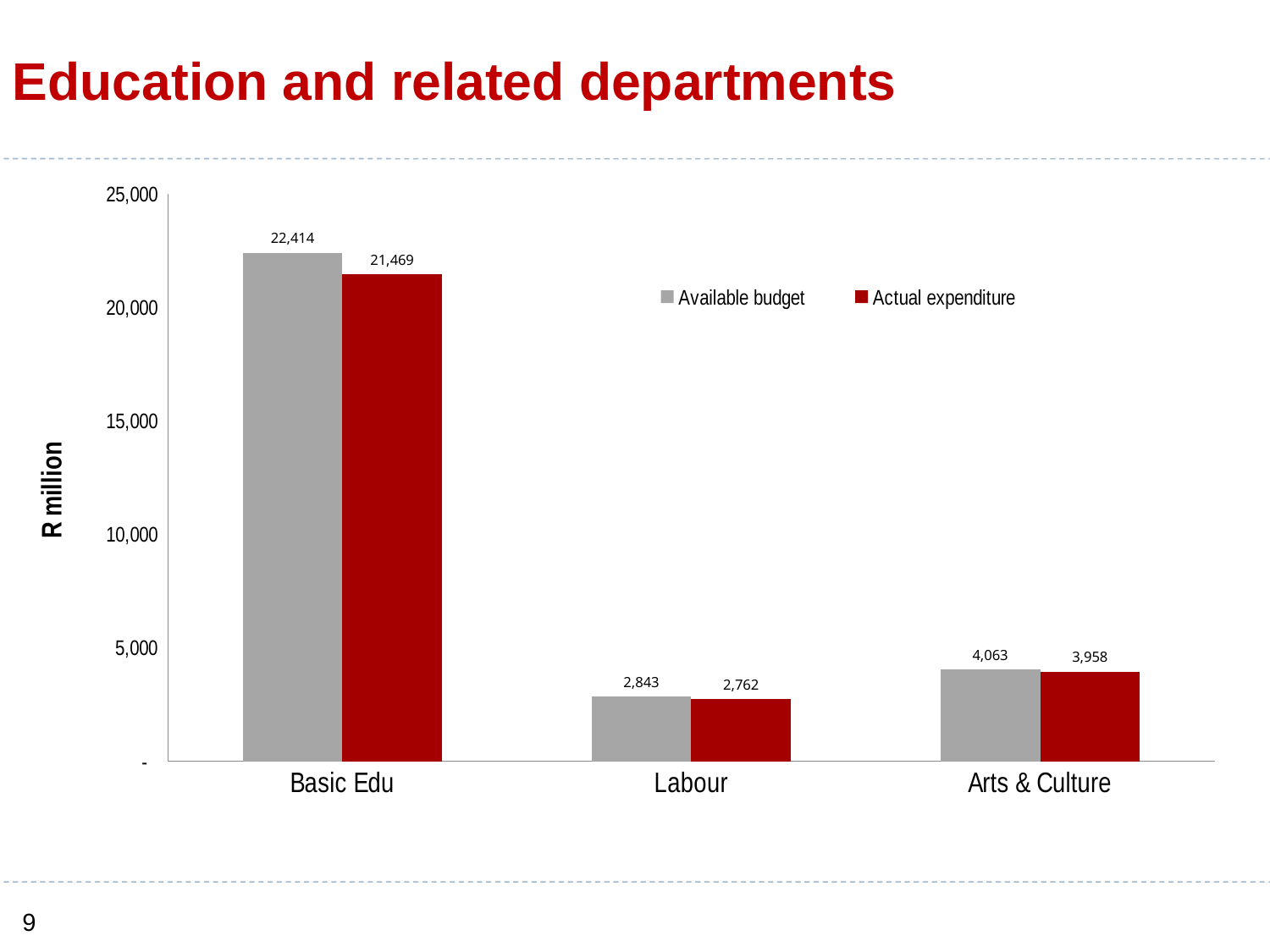
What is the Available budget for Basic Edu? 22,414 Which department has the highest Available budget? Basic Edu What is the Actual expenditure for Arts & Culture? 3,958 What is the Available budget for Arts & Culture? 4,063 What is the Actual expenditure for Labour? 2,762 What kind of chart is shown on the slide? Bar chart How many departments are shown on the x axis? 3 Which department has the lowest Actual expenditure? Labour How many series does the legend list? 2 Which is larger for Labour, the Available budget or the Actual expenditure? Available budget What is the difference between the Available budget and Actual expenditure for Basic Edu? 945 What is the difference between the Available budget for Arts & Culture and the Available budget for Labour? 1,220